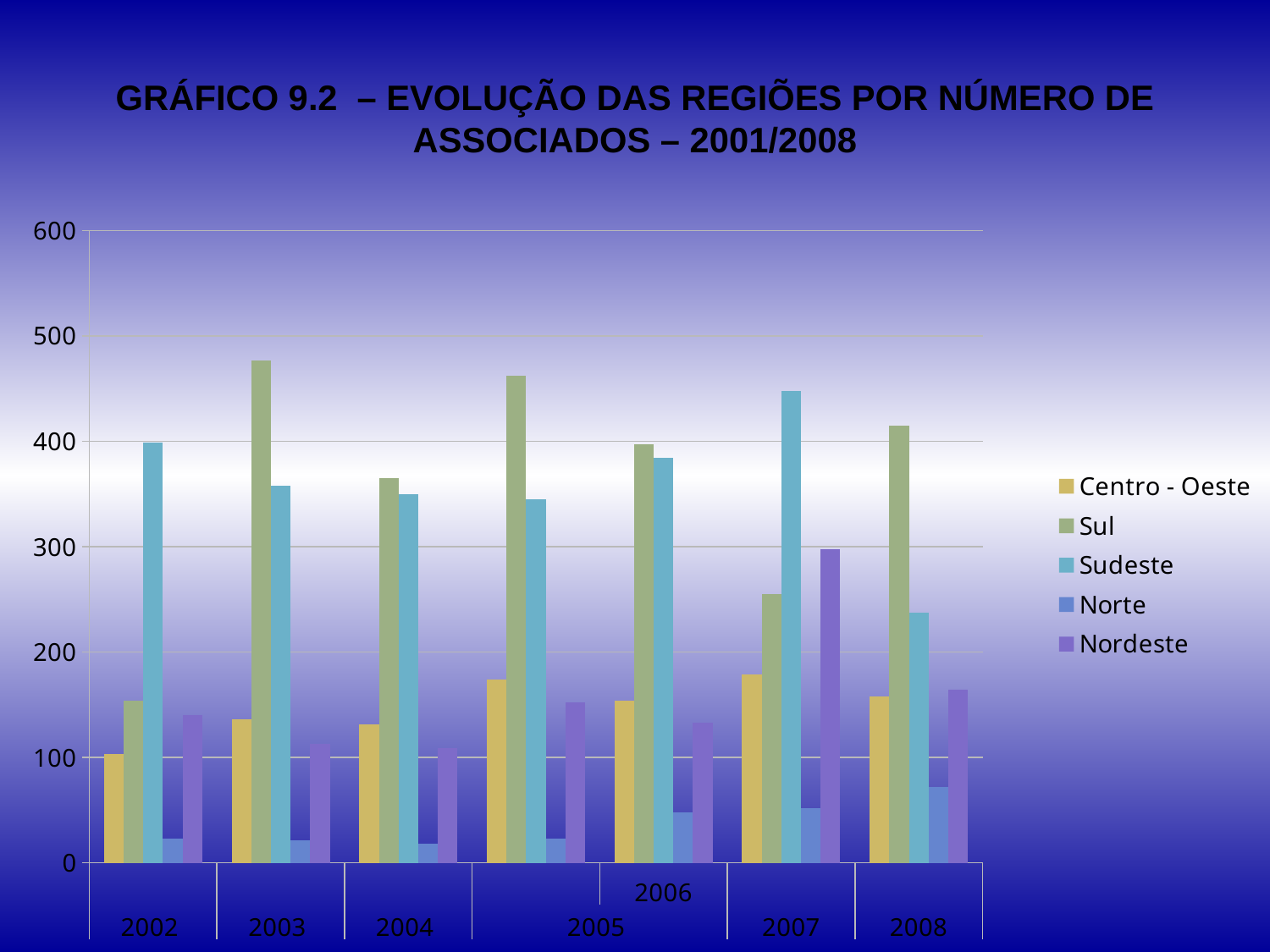
In which year is the Sudeste value highest? 2007 Which region has the lowest value in 2007? Norte How many series does the legend list? 5 Is the value for Sul in 2003 greater or less than 400? greater Is the value for Norte in 2008 greater or less than 100? less Is the value for Nordeste in 2007 greater or less than 200? greater What kind of chart is shown on the slide? bar chart Which region has the highest value in 2002? Sudeste In which year is the Sul value lowest? 2002 How many years are shown along the x axis? 7 Which region is listed last in the legend? Nordeste In 2008, which is larger: Sul or Sudeste? Sul